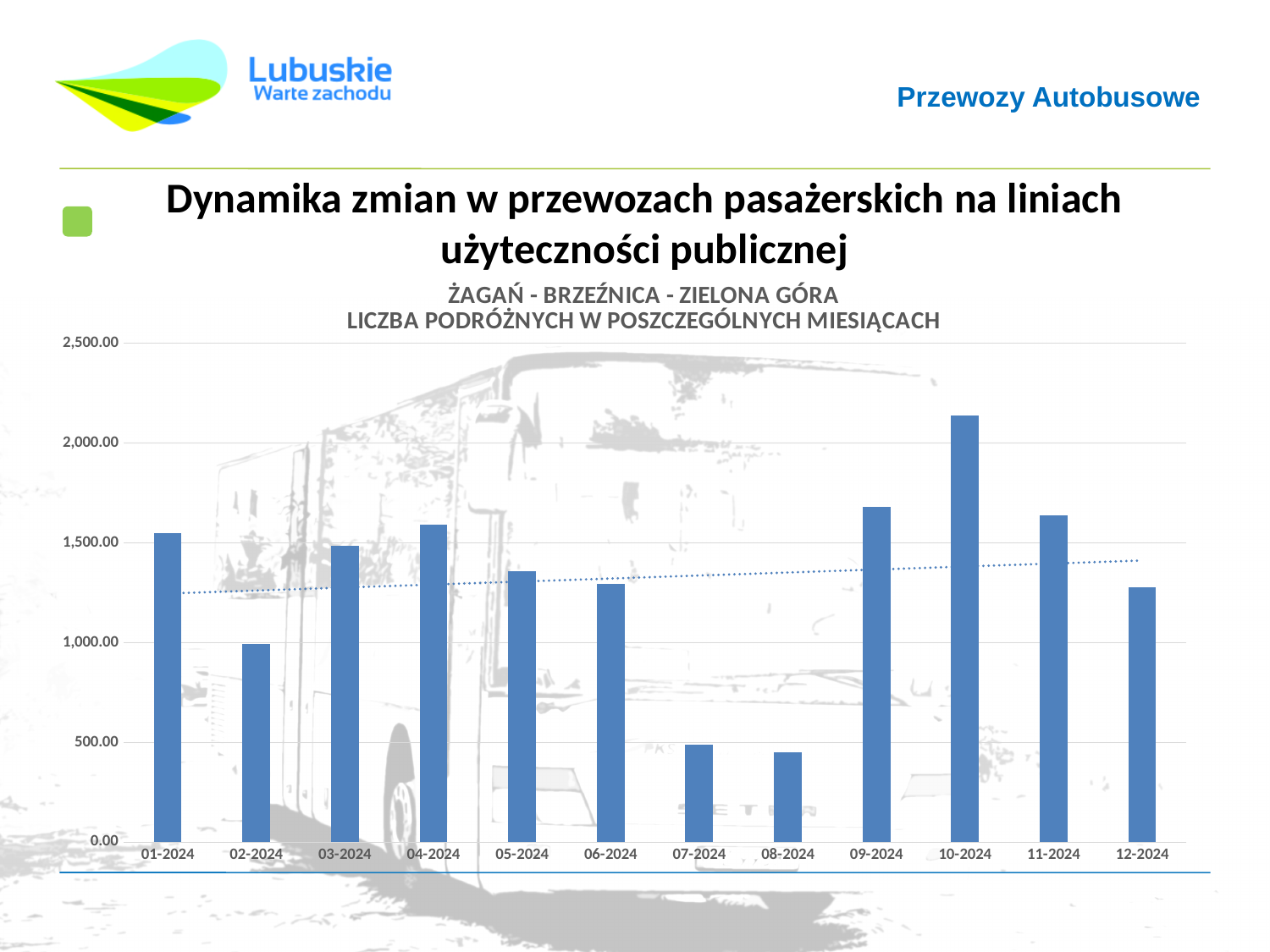
Is the value for 09-2024 greater or less than 1,500.00? greater Which month has the highest number of passengers? 10-2024 Does the dotted trend line rise or fall from 01-2024 to 12-2024? rise Is the value for 08-2024 greater or less than 500.00? less Is the value for 05-2024 greater or less than 1,500.00? less Which route is named in the chart's subtitle? ŻAGAŃ - BRZEŹNICA - ZIELONA GÓRA Which is larger, the value for 04-2024 or the value for 02-2024? 04-2024 How many months (categories) are plotted on the x axis? 12 What kind of chart is shown on the slide? bar chart Which is larger, the value for 09-2024 or the value for 12-2024? 09-2024